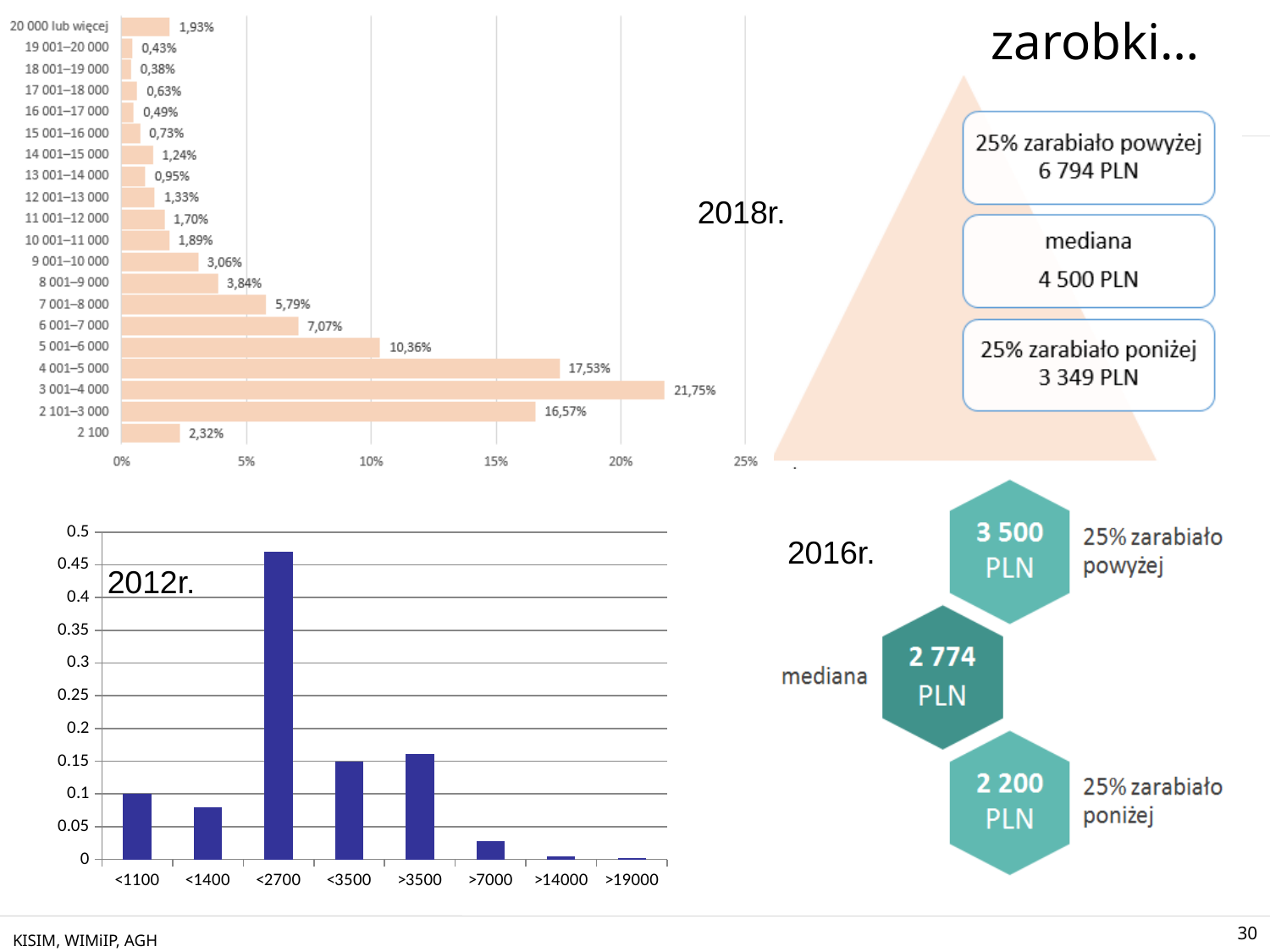
In the 2012r. chart, which category has the highest bar? <2700 In the 2018r. chart, which category has the lowest percentage? 18 001–19 000 In the 2018r. chart, which is larger: the value for 6 001–7 000 or the value for 7 001–8 000? 6 001–7 000 In the 2018r. chart, what percentage is shown for the 3 001–4 000 category? 21,75% How many categories are shown in the 2018r. chart? 20 In the 2018r. chart, what is the difference between the percentages for 4 001–5 000 and 2 101–3 000? 0,96% In the 2018r. chart, what percentage is shown for the 20 000 lub więcej category? 1,93% What type of chart is the 2018r. chart? bar chart In the 2018r. chart, what percentage is shown for the 5 001–6 000 category? 10,36% In the 2018r. chart, which category has the highest percentage? 3 001–4 000 In the 2012r. chart, is the value for <2700 greater or less than 0.4? greater How many categories are shown on the x axis of the 2012r. chart? 8